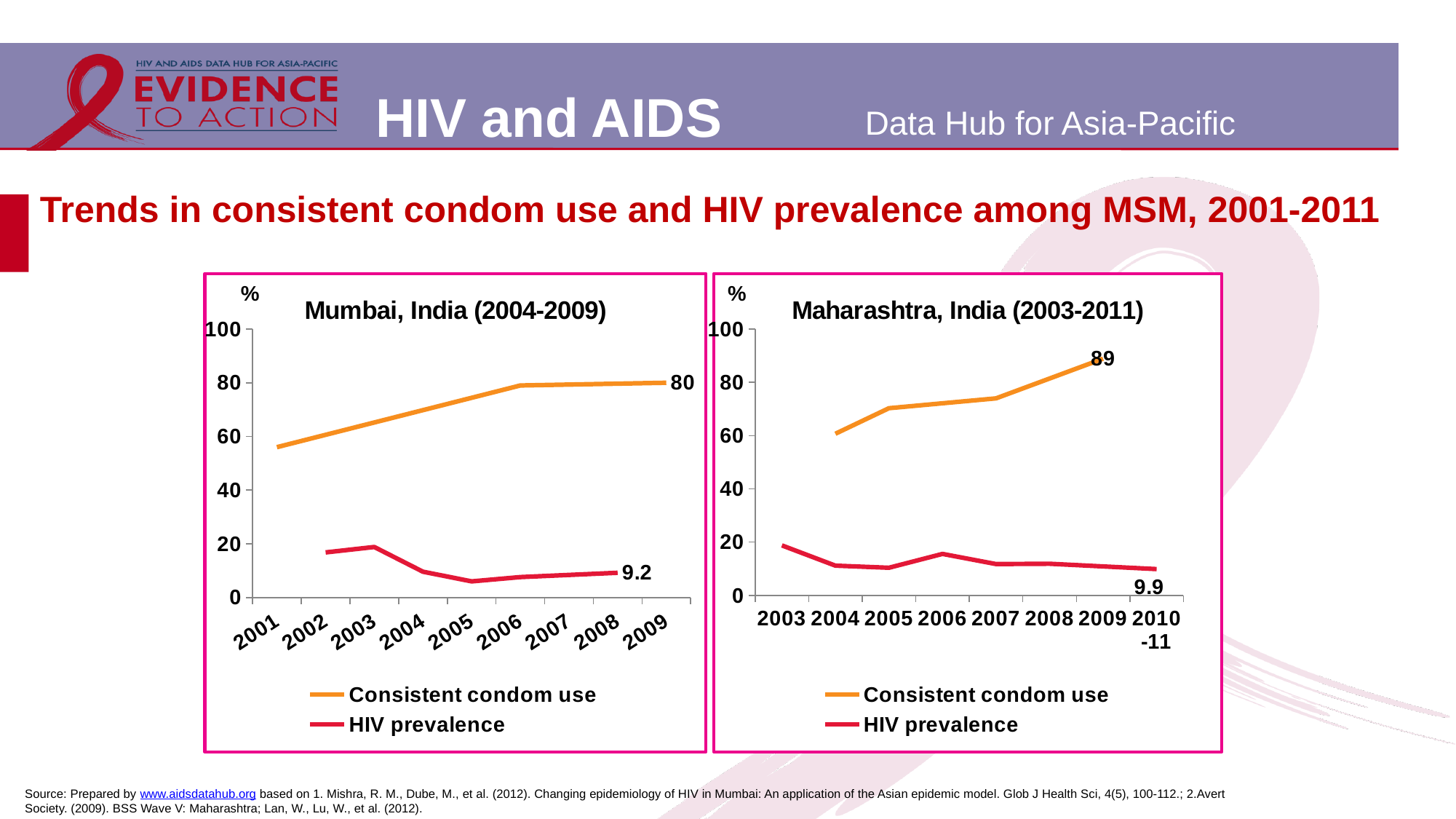
In the Maharashtra, India (2003-2011) chart, is the value of consistent condom use in 2005 greater or less than 60? greater What type of chart is the Mumbai, India (2004-2009) chart? line chart In the Mumbai, India (2004-2009) chart, what is the last labelled value of HIV prevalence? 9.2 In the Maharashtra, India (2003-2011) chart, what is the value of consistent condom use in 2009? 89 In the Maharashtra, India (2003-2011) chart, what is the value of HIV prevalence in 2010-11? 9.9 How many series does the legend of the Maharashtra, India (2003-2011) chart list? 2 In the Mumbai, India (2004-2009) chart, does consistent condom use rise or fall over the years shown? rise Which is larger: consistent condom use in 2009 in the Mumbai chart or in the Maharashtra chart? Maharashtra What is the difference between the 2009 consistent condom use value in the Maharashtra chart (89) and in the Mumbai chart (80)? 9 In the Mumbai, India (2004-2009) chart, what is the value of consistent condom use in 2009? 80